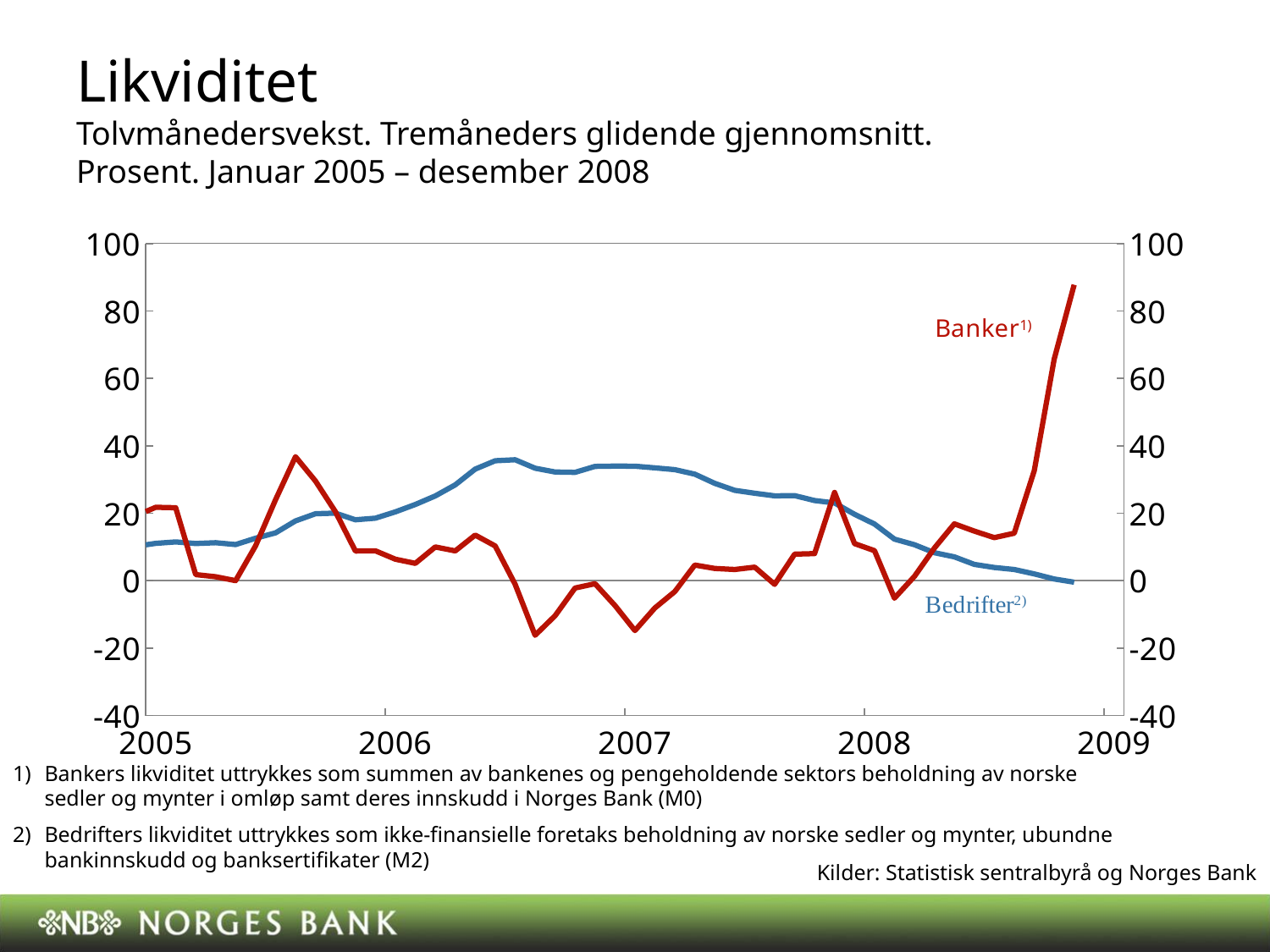
Which series reaches the lowest value on the chart, Banker or Bedrifter? Banker What kind of chart is shown on the slide? line chart Which series reaches the highest value on the chart, Banker or Bedrifter? Banker Is the highest value of the Bedrifter series greater or less than 40? less Which colour is used for the Banker series? red Is the value for Bedrifter at the end of 2008 greater or less than 20? less What is the title of the chart on the slide? Likviditet Does the Bedrifter series rise or fall over the course of 2008? fall At the start of 2007, which series has the larger value, Banker or Bedrifter? Bedrifter How many series are plotted in the chart? 2 Is the lowest value of the Banker series greater or less than -20? greater